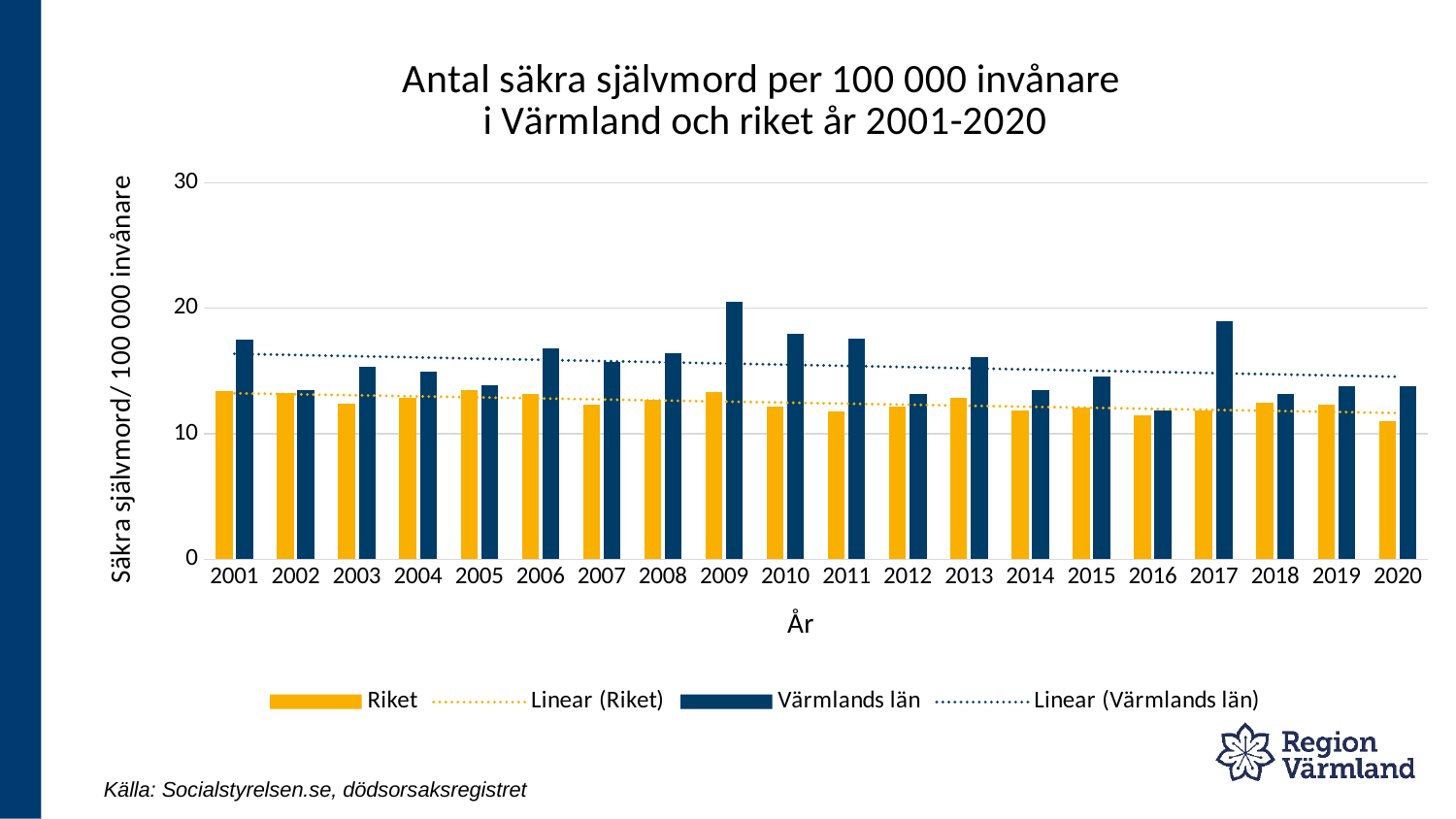
Is the value for Värmlands län in 2017 greater or less than 15? greater How many years are shown on the x axis? 20 Is the value for Riket in 2020 greater or less than 12? less What is the title of the chart? Antal säkra självmord per 100 000 invånare i Värmland och riket år 2001-2020 How many entries does the legend list? 4 In 2009, which is larger: the value for Riket or for Värmlands län? Värmlands län What kind of chart is shown on the slide? bar chart In which year is the value for Värmlands län highest? 2009 Is the value for Värmlands län in 2009 greater or less than 15? greater According to the dotted linear trend line for Värmlands län, do values rise or fall from 2001 to 2020? fall What is the label of the x axis? År In which year is the value for Värmlands län lowest? 2016